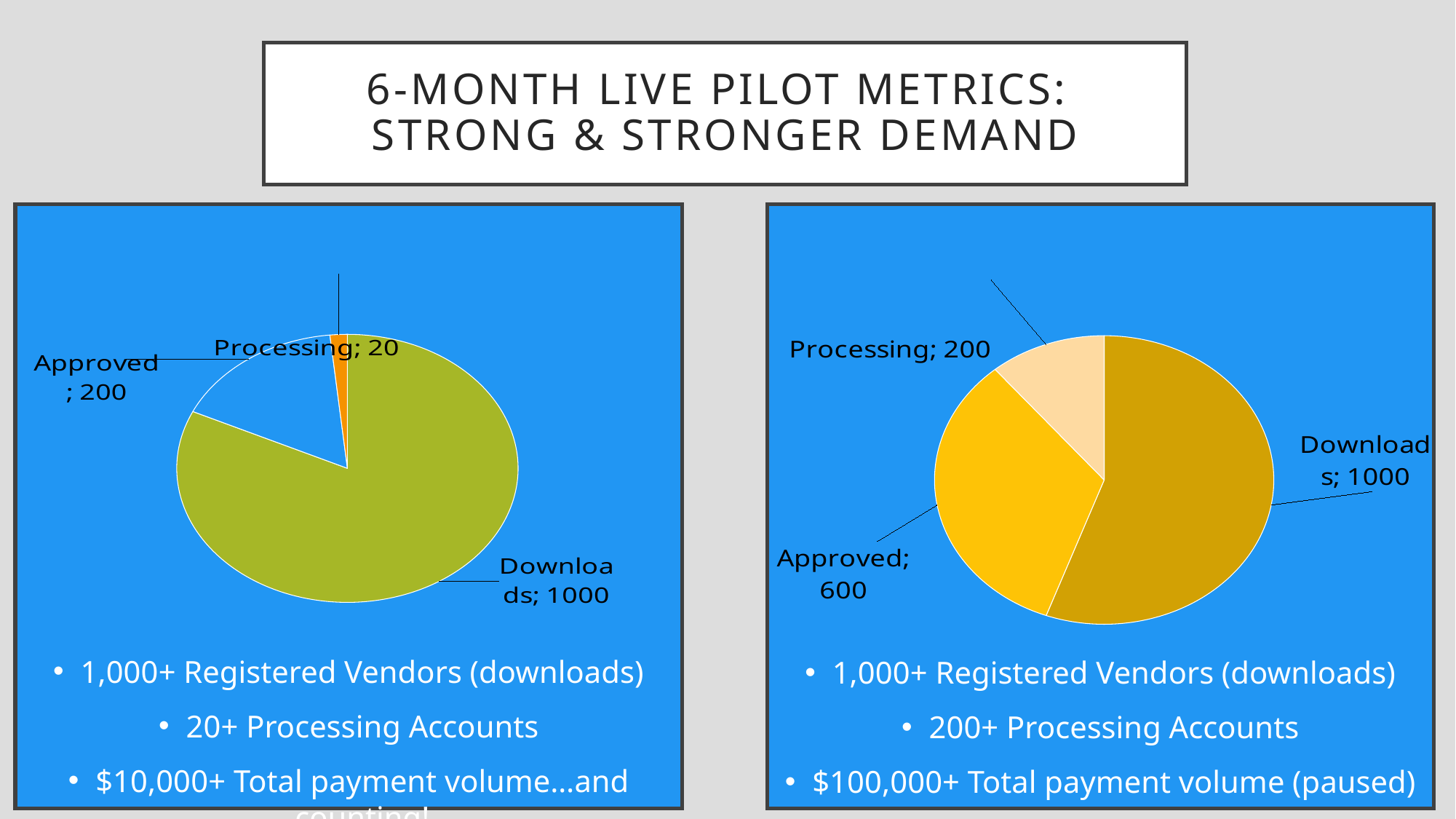
How many slices does the left pie chart have? 3 In the left pie chart, which category has the largest slice? Downloads In the right pie chart, what is the value for Approved? 600 In the right pie chart, what is the value for Processing? 200 In the left pie chart, what is the value for Processing? 20 In the left pie chart, what is the difference between Approved and Processing? 180 In the right pie chart, what share of the total does Approved represent? 33.3% In the right pie chart, what is the difference between Downloads and Approved? 400 In the right pie chart, which is larger, Approved or Processing? Approved What type of chart is shown on the right side of the slide? Pie chart In the right pie chart, which category has the smallest slice? Processing In the left pie chart, what is the value for Approved? 200